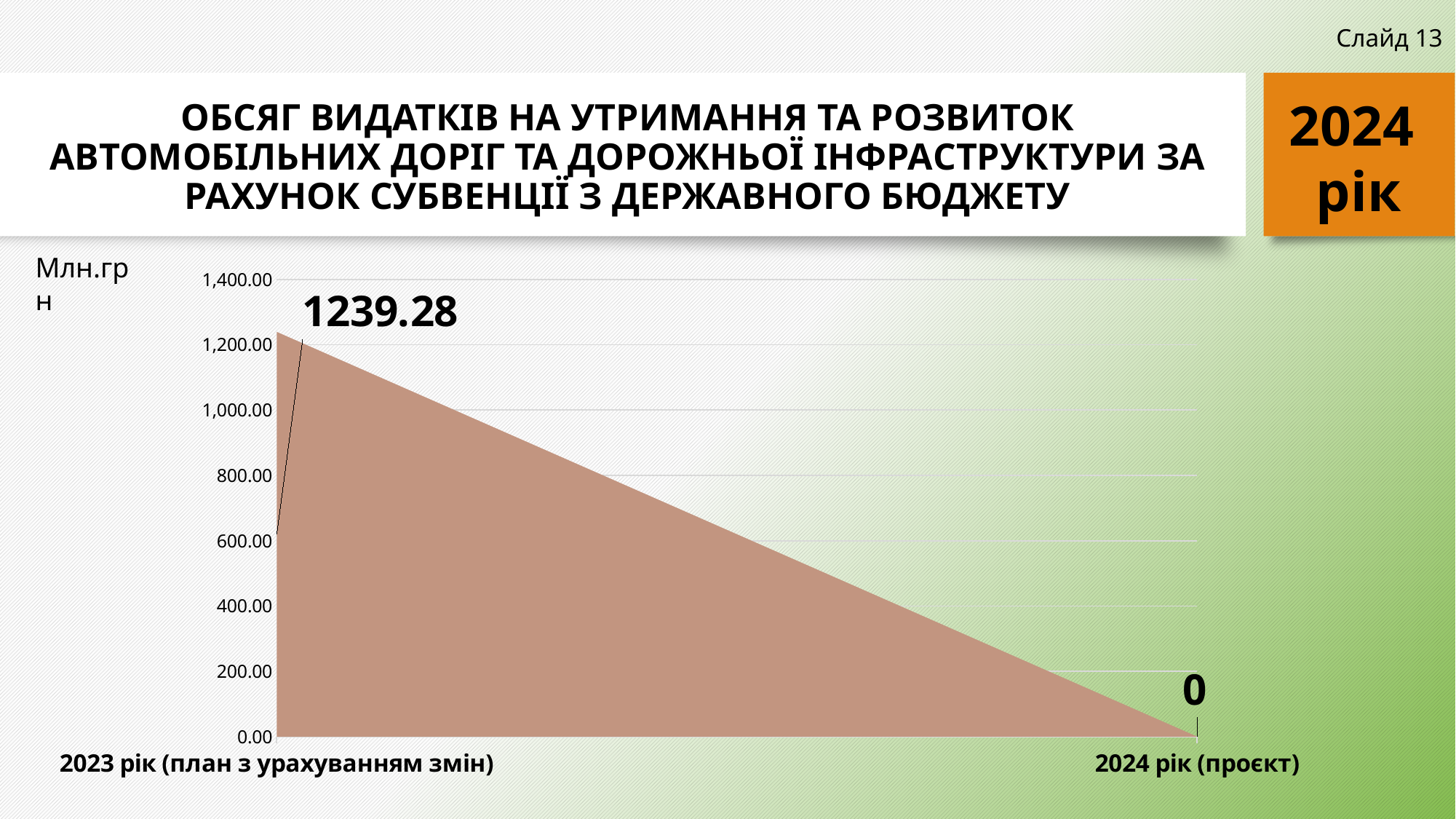
What kind of chart is shown on the slide? area chart Which category has the lowest value? 2024 рік (проєкт) Which category has the highest value? 2023 рік (план з урахуванням змін) What is the highest tick value shown on the vertical axis? 1,400.00 What is the value for 2023 рік (план з урахуванням змін)? 1239.28 What unit is shown for the values on the chart? Млн.грн Which is larger, the value for 2023 рік (план з урахуванням змін) or the value for 2024 рік (проєкт)? 2023 рік (план з урахуванням змін) What is the difference between the value for 2023 рік (план з урахуванням змін) and the value for 2024 рік (проєкт)? 1239.28 What is the value for 2024 рік (проєкт)? 0 How many categories are plotted on the x axis? 2 Do the values rise or fall from 2023 рік to 2024 рік? fall Is the value for 2023 рік (план з урахуванням змін) greater or less than 1,000.00? greater